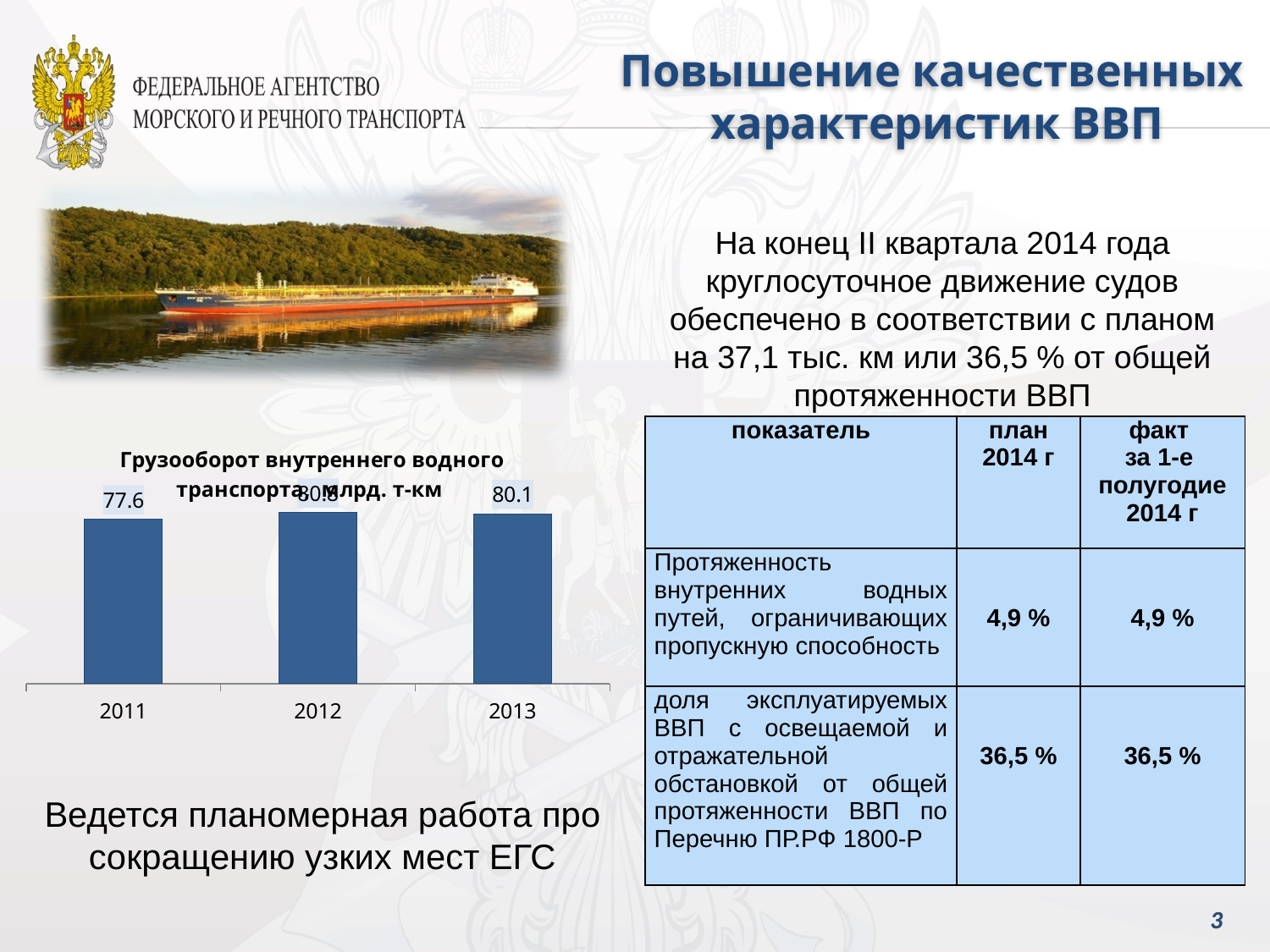
Which is larger, the value for 2011 or the value for 2013? 2013 What is the value for 2011 in the chart? 77.6 How many years are shown on the x axis of the chart? 3 Which year has the lowest value in the chart? 2011 What type of chart is shown on the slide? bar chart What is the title of the chart? Грузооборот внутреннего водного транспорта, млрд. т-км What is the value for 2013 in the chart? 80.1 Does the value rise or fall from 2011 to 2013? rise What is the difference between the values for 2013 and 2011? 2.5 What colour are the bars in the chart? blue